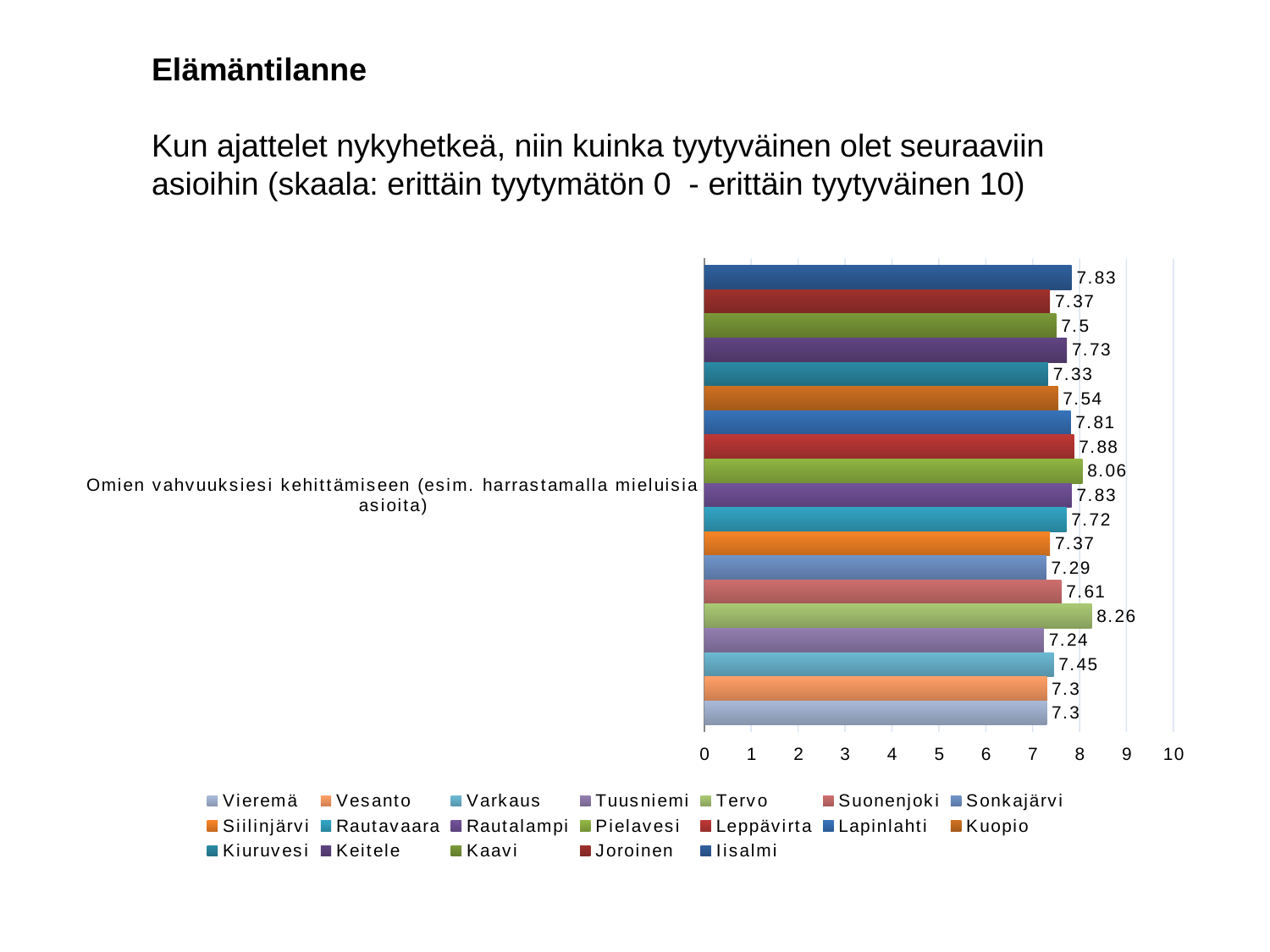
Which municipality has the highest value? Tervo What kind of chart is shown on the slide? Bar chart Which is larger, the value for Leppävirta or the value for Kiuruvesi? Leppävirta What is the difference between the values for Pielavesi and Leppävirta? 0.18 What is the category label shown on the left of the chart? Omien vahvuuksiesi kehittämiseen (esim. harrastamalla mieluisia asioita) What is the value for Kuopio? 7.54 What is the value for Pielavesi? 8.06 What is the value for Tuusniemi? 7.24 What is the difference between the values for Tervo and Tuusniemi? 1.02 Which municipality has the lowest value? Tuusniemi What is the value for Tervo? 8.26 How many series does the legend list? 19